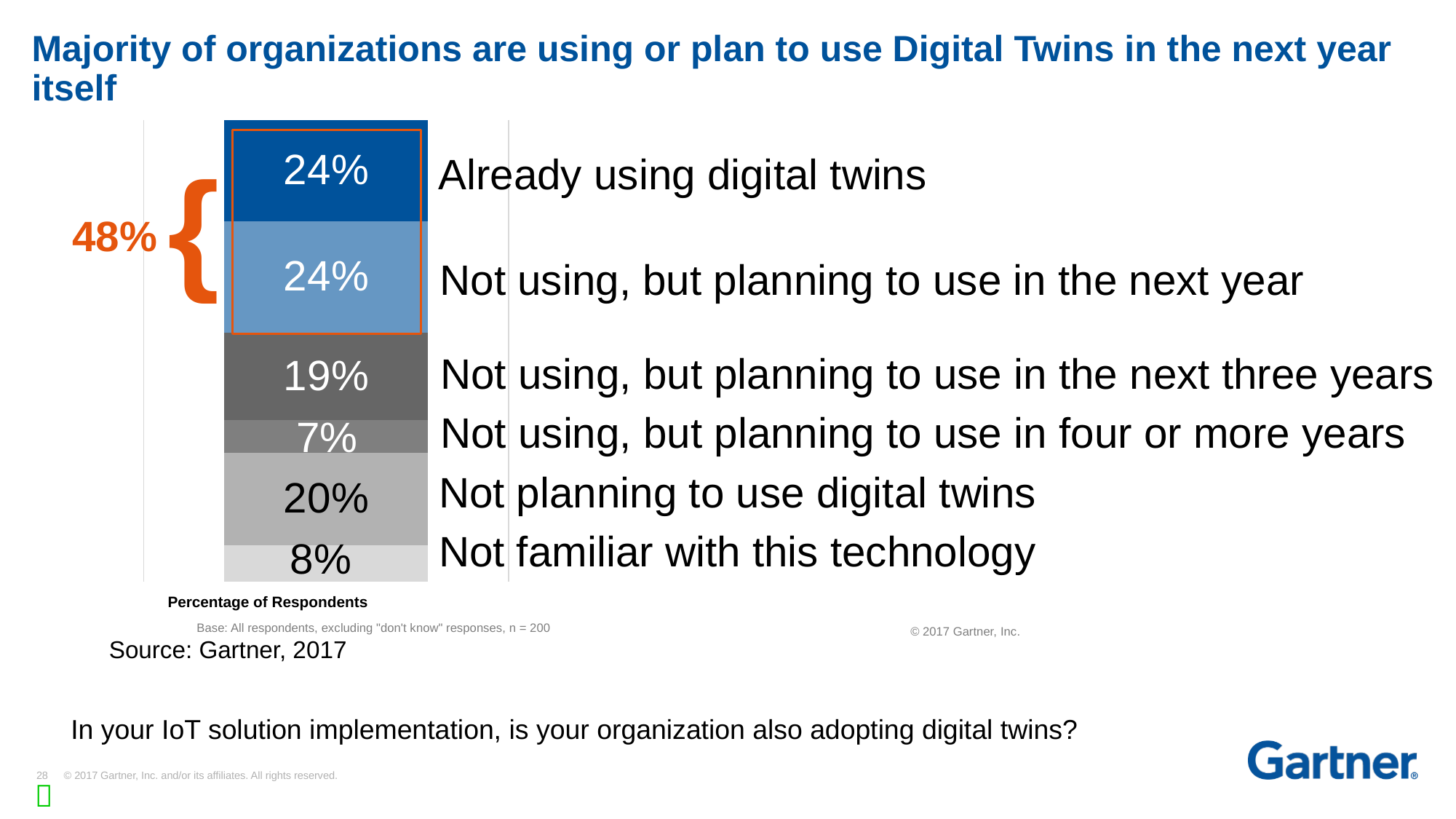
What is the difference between the share of respondents not planning to use digital twins and the share not familiar with this technology? 12% What percentage of respondents are not using digital twins but planning to use them in the next year? 24% What type of chart is shown on the slide? Stacked bar chart What percentage of respondents are not familiar with this technology? 8% What percentage of respondents are not using digital twins but planning to use them in four or more years? 7% Which response category has the smallest share of respondents? Not using, but planning to use in four or more years What percentage of respondents are not using digital twins but planning to use them in the next three years? 19% What is the combined percentage of respondents who are already using digital twins or planning to use them in the next year, as marked by the bracket? 48% What percentage of respondents are already using digital twins? 24% What percentage of respondents are not planning to use digital twins? 20% Which is larger: the share planning to use digital twins in the next three years or the share not planning to use digital twins? Not planning to use digital twins How many response categories are shown in the stacked bar? 6